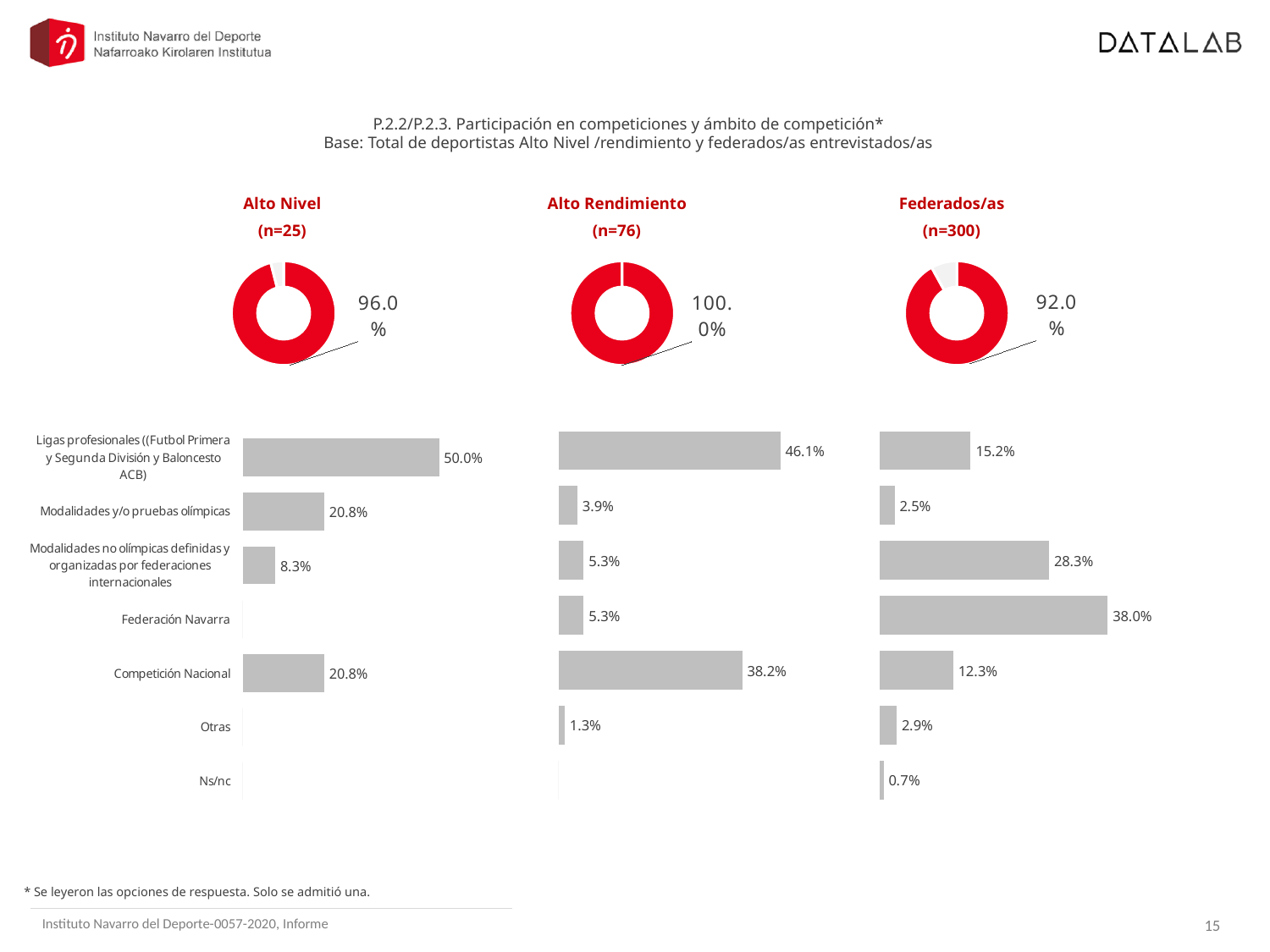
In the Federados/as bar chart, which category has the lowest value? Ns/nc In the Federados/as bar chart, which is larger: Modalidades no olímpicas or Ligas profesionales? Modalidades no olímpicas In the Federados/as donut chart, what percentage is shown? 92.0% Which of the three donut charts shows the highest percentage? Alto Rendimiento In the Alto Nivel bar chart, what is the value for Modalidades no olímpicas? 8.3% How many categories are listed in the bar charts? 7 In the Alto Rendimiento bar chart, what is the difference between Ligas profesionales and Competición Nacional? 7.9% In the Alto Nivel bar chart, what is the value for Ligas profesionales? 50.0% In the Alto Rendimiento bar chart, what is the value for Competición Nacional? 38.2% What kind of chart is used for the Alto Nivel breakdown by competition type? Bar chart In the Federados/as bar chart, which category has the highest value? Federación Navarra In the Alto Nivel donut chart, what percentage is shown? 96.0%